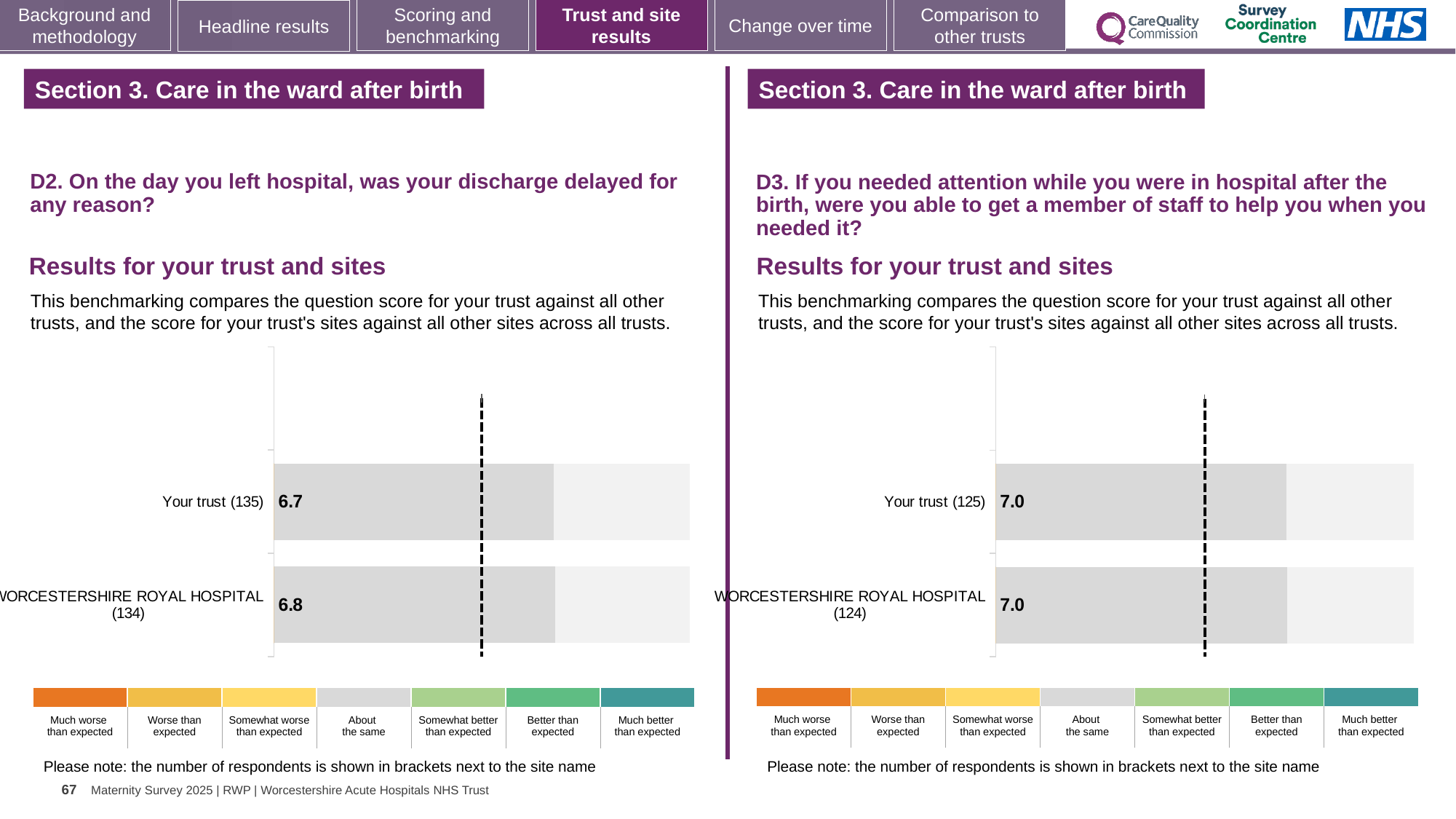
In the D2 chart on the left, what is the score for WORCESTERSHIRE ROYAL HOSPITAL (134)? 6.8 In the D3 chart on the right, what is the difference between the score for Your trust (125) and the score for WORCESTERSHIRE ROYAL HOSPITAL (124)? 0.0 How many benchmark categories does the colour key below the D3 chart on the right list? 7 In the D2 chart on the left, which has the higher score: Your trust (135) or WORCESTERSHIRE ROYAL HOSPITAL (134)? WORCESTERSHIRE ROYAL HOSPITAL (134) How many respondents are shown in brackets for Your trust in the D2 chart on the left? 135 How many bars are plotted in the D2 chart on the left? 2 In the D2 chart on the left, what is the score for Your trust (135)? 6.7 In the D3 chart on the right, what is the score for WORCESTERSHIRE ROYAL HOSPITAL (124)? 7.0 In the D3 chart on the right, what is the score for Your trust (125)? 7.0 What type of chart is used for the D3 results on the right? Bar chart How many bars are plotted in the D3 chart on the right? 2 In the D2 chart on the left, what is the difference between the score for WORCESTERSHIRE ROYAL HOSPITAL (134) and the score for Your trust (135)? 0.1